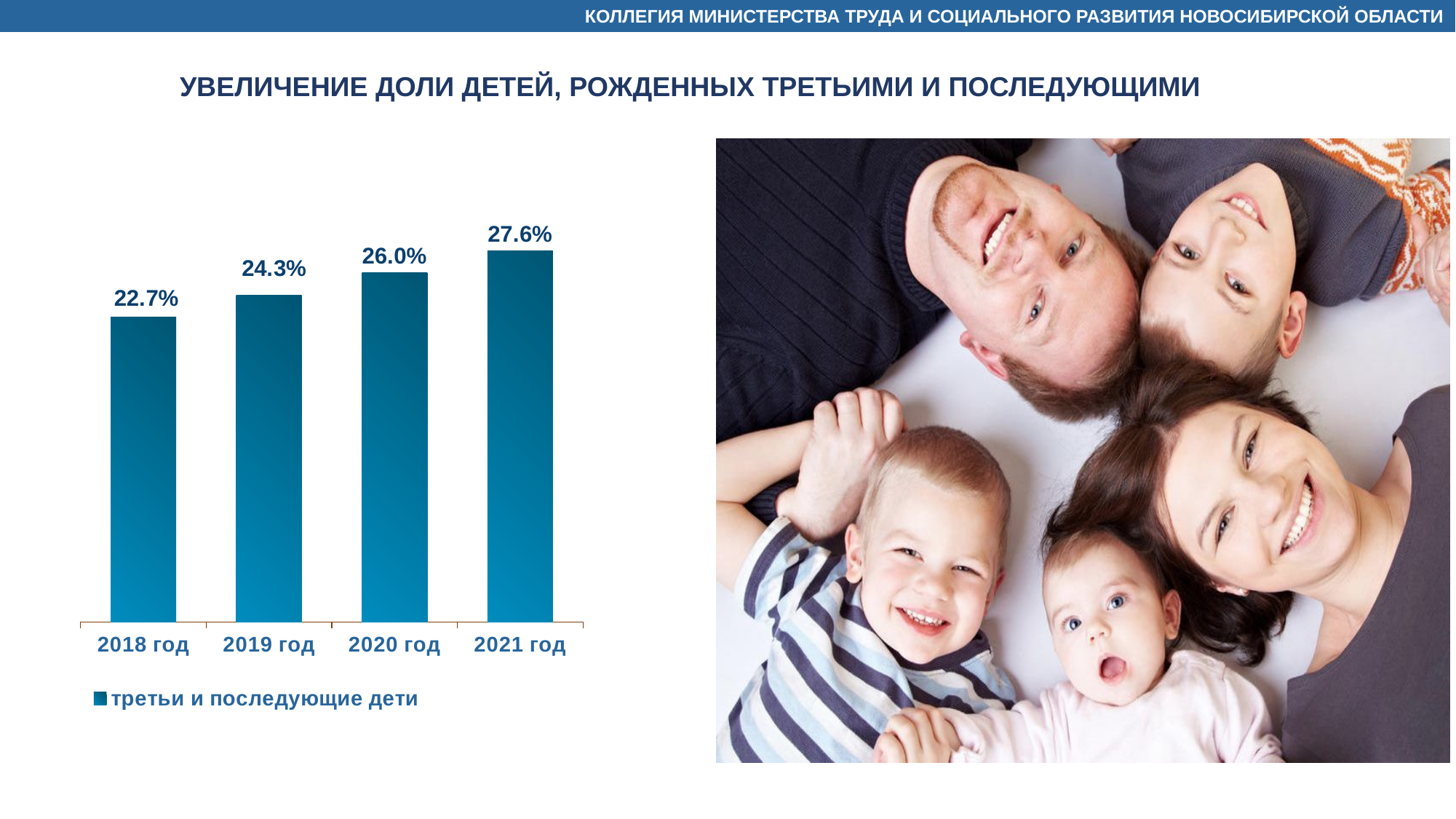
How many series does the legend list? 1 Do the values rise or fall from 2018 год to 2021 год? rise Which year has the lowest value? 2018 год How many years are shown on the chart? 4 Which is larger, the value for 2019 год or the value for 2020 год? 2020 год What is the difference between the values for 2019 год and 2018 год? 1.6% What is the value for 2020 год? 26.0% What is the value for 2018 год? 22.7% What is the value for 2021 год? 27.6% What kind of chart is shown on the slide? bar chart What is the difference between the values for 2021 год and 2018 год? 4.9% Which year has the highest value? 2021 год